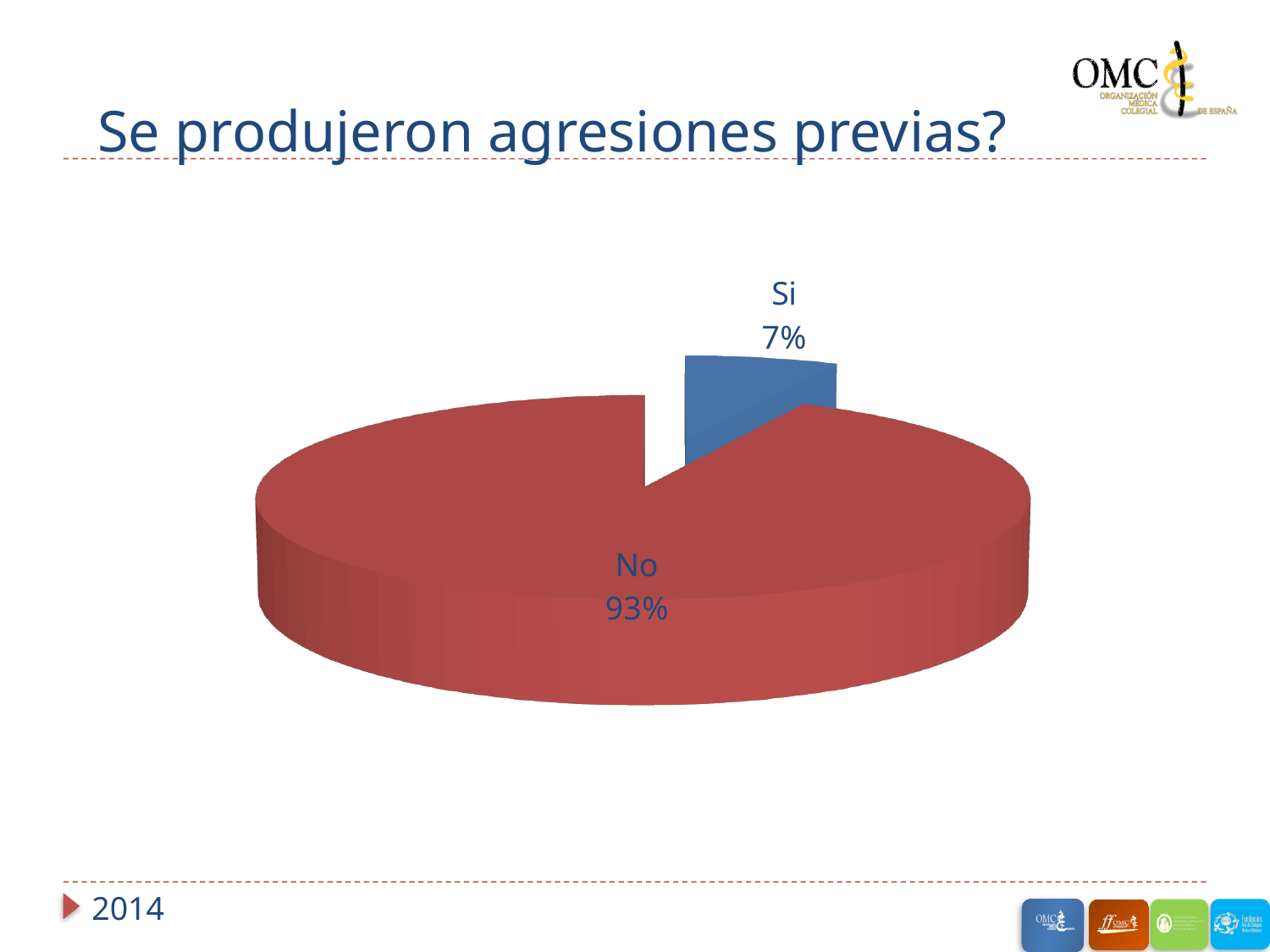
What share of the pie does the "No" slice represent? 93% What kind of chart is shown on the slide? pie chart What is the difference in percentage points between the "No" and "Si" slices? 86 Which slice of the pie is the smallest? Si What colour is the "Si" slice of the pie? blue What is the total of the two slice percentages shown on the pie chart? 100% What share of the pie does the "Si" slice represent? 7% Which slice of the pie is the largest? No Which is larger, the "Si" slice or the "No" slice? No What is the title of the slide containing the pie chart? Se produjeron agresiones previas? How many slices does the pie chart have? 2